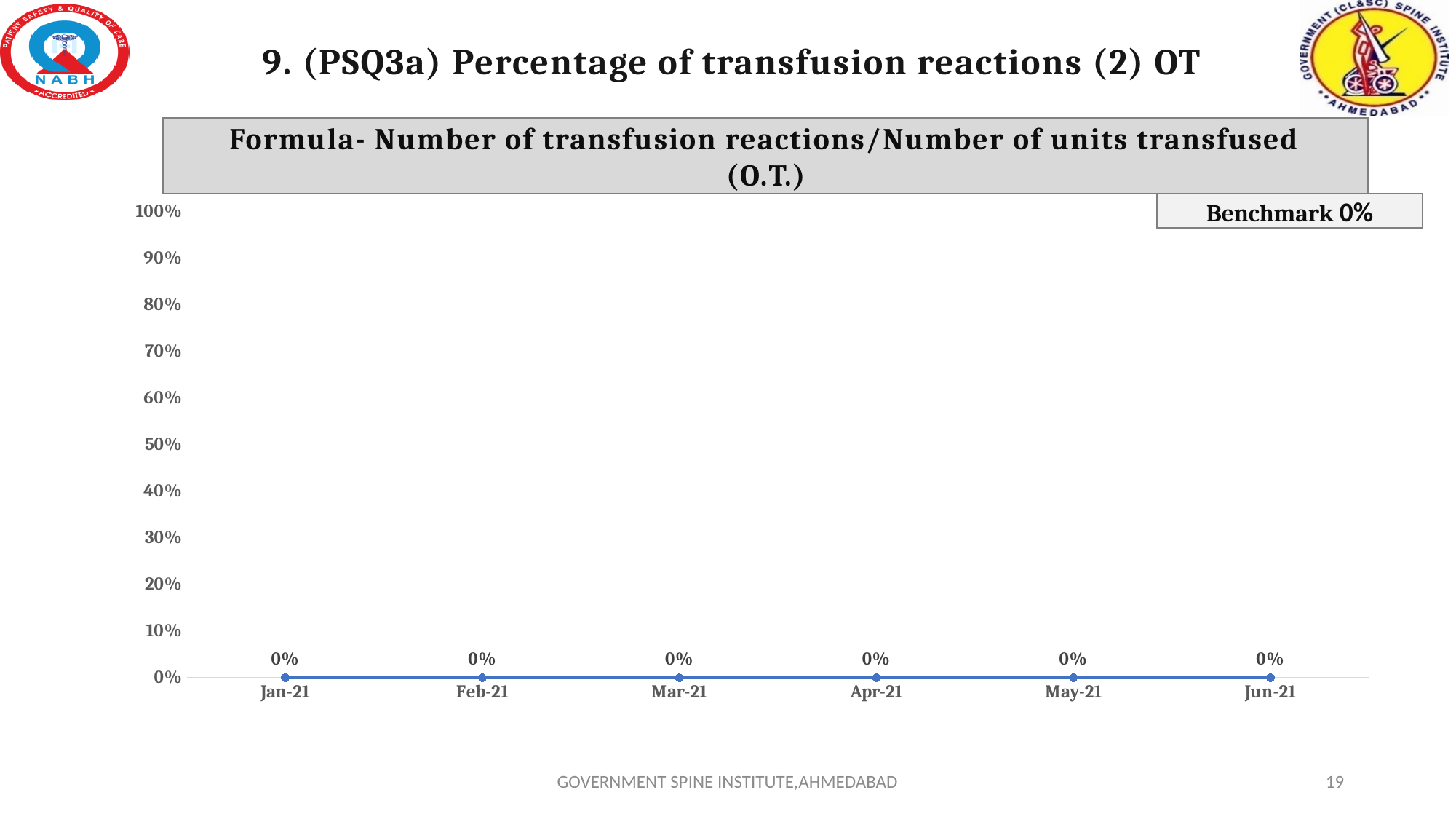
What is the highest value shown on the y axis? 100% What kind of chart is shown on the slide? line chart What is the value for Jun-21? 0% What is the value for Apr-21? 0% What is the value for Jan-21? 0% What is the first month shown on the x axis? Jan-21 What benchmark value is shown on the slide? 0% What is the difference between the values for Mar-21 and May-21? 0% How many data points are plotted on the chart? 6 What is the last month shown on the x axis? Jun-21 Do the values rise, fall, or stay flat from Jan-21 to Jun-21? stay flat Is the value for Feb-21 greater or less than 10%? less